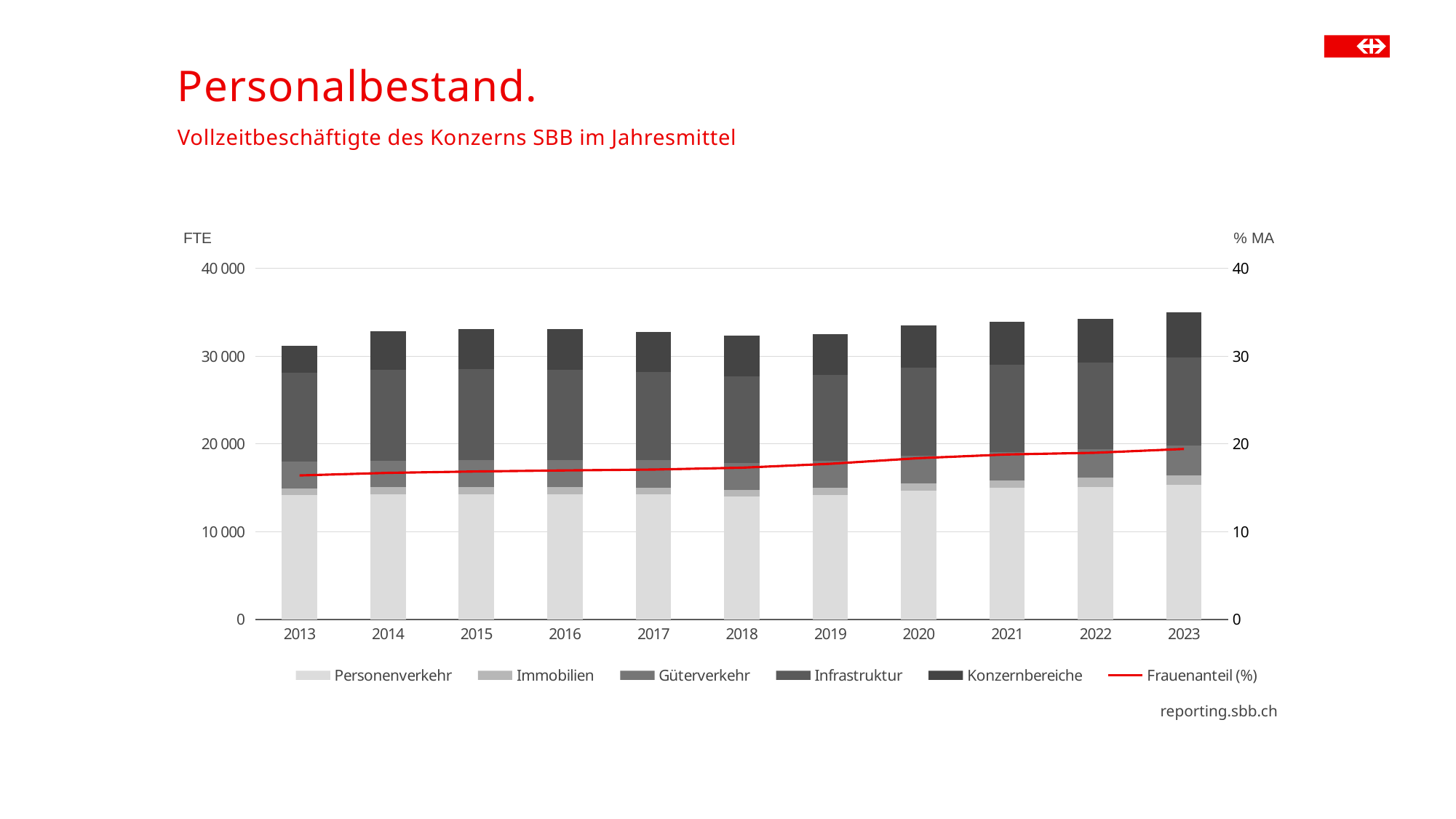
How many series does the chart legend list? 6 Which year has the lowest total FTE bar? 2013 Which year has the highest total FTE bar? 2023 What kind of chart is shown on the slide? Stacked bar chart with a line Which series is drawn as a red line in the chart? Frauenanteil (%) Which total FTE bar is taller, 2013 or 2023? 2023 How many years are shown on the x axis of the chart? 11 Is the Frauenanteil (%) value for 2013 greater or less than 10? greater Does the Frauenanteil (%) line rise or fall from 2013 to 2023? rises Is the total FTE bar for 2018 greater or less than 40 000? less What is the subtitle of the chart on the slide? Vollzeitbeschäftigte des Konzerns SBB im Jahresmittel Is the total FTE bar for 2023 greater or less than 30 000? greater